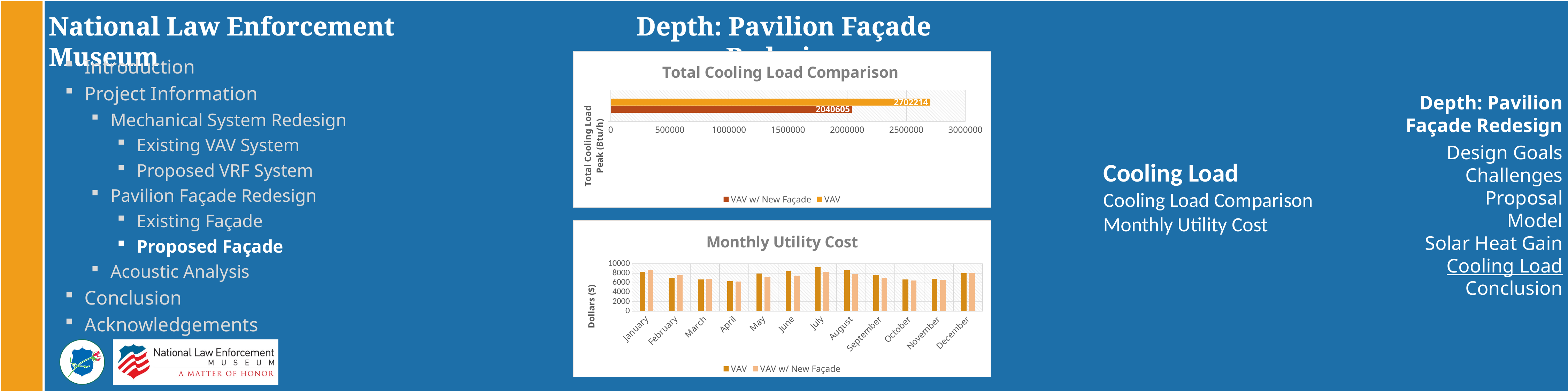
In the Total Cooling Load Comparison chart, what is the label on the vertical axis? Total Cooling Load Peak (Btu/h) In the Total Cooling Load Comparison chart, what is the difference between the VAV value and the VAV w/ New Façade value? 661609 In the Monthly Utility Cost chart, what is the label on the vertical axis? Dollars ($) In the Monthly Utility Cost chart, how many months are shown on the x axis? 12 In the Total Cooling Load Comparison chart, what is the value for VAV w/ New Façade? 2040605 In the Total Cooling Load Comparison chart, which series has the higher total cooling load peak? VAV In the Monthly Utility Cost chart, is the VAV value for July greater or less than 8000? greater In the Monthly Utility Cost chart, which month has the highest VAV utility cost? July In the Total Cooling Load Comparison chart, what is the value for VAV? 2702214 What kind of chart is the Total Cooling Load Comparison chart? Bar chart In the Monthly Utility Cost chart, is the VAV value for April greater or less than 8000? less In the Total Cooling Load Comparison chart, how many series does the legend list? 2